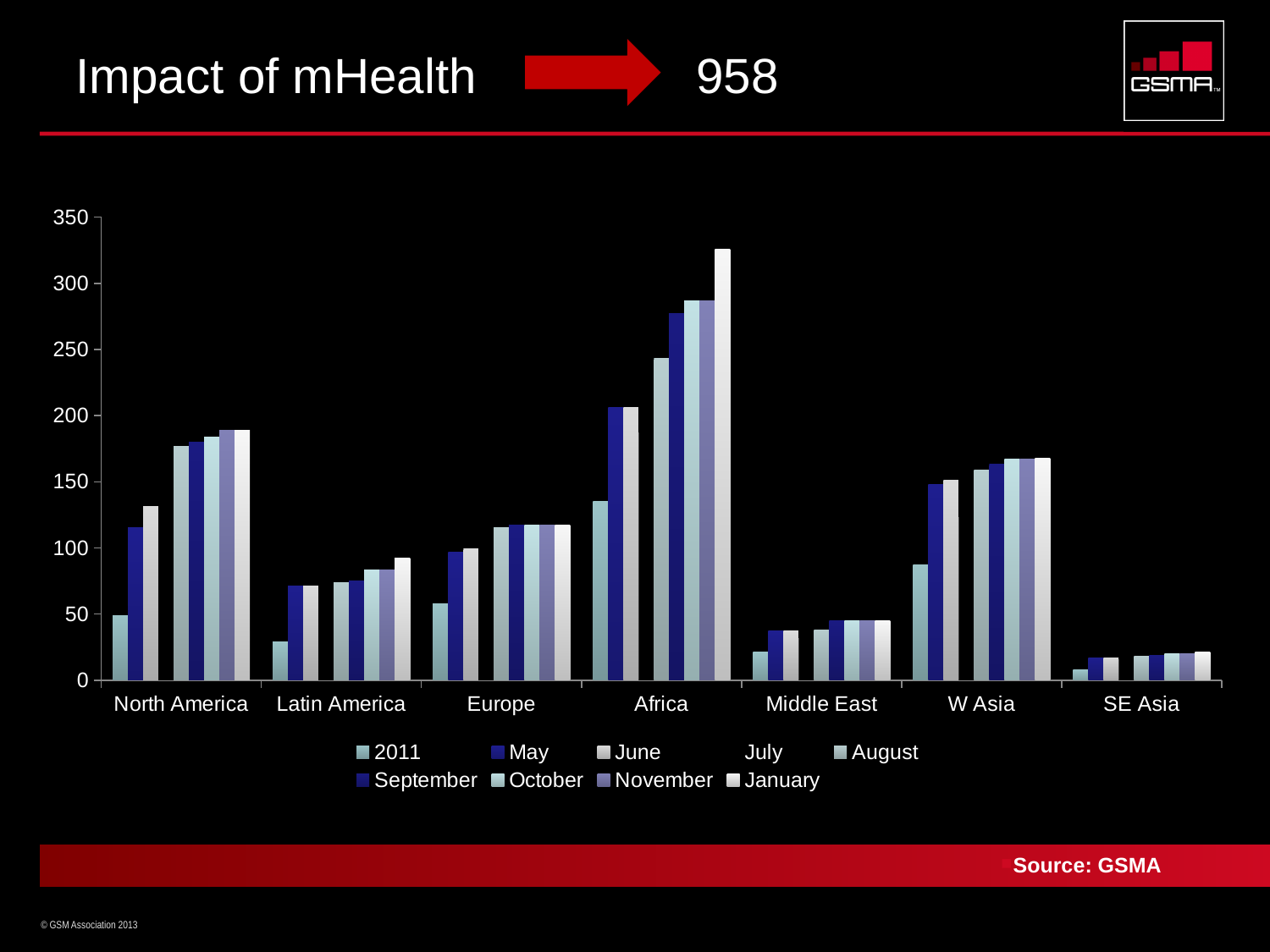
How many regions are shown on the x axis of the chart? 7 Is the 2011 value for W Asia greater or less than 100? less Which region has the tallest bar in the chart? Africa Is the January value for Africa greater or less than 300? greater How many series does the chart's legend list? 9 Is the 2011 value for Latin America greater or less than 50? less Which is larger, the January value for W Asia or the January value for Europe? W Asia Within Africa, do the bars rise or fall from the 2011 series to the January series? rise What is the source cited at the bottom of the slide? GSMA Which region has the lowest bars in the chart? SE Asia What kind of chart is shown on the slide? bar chart